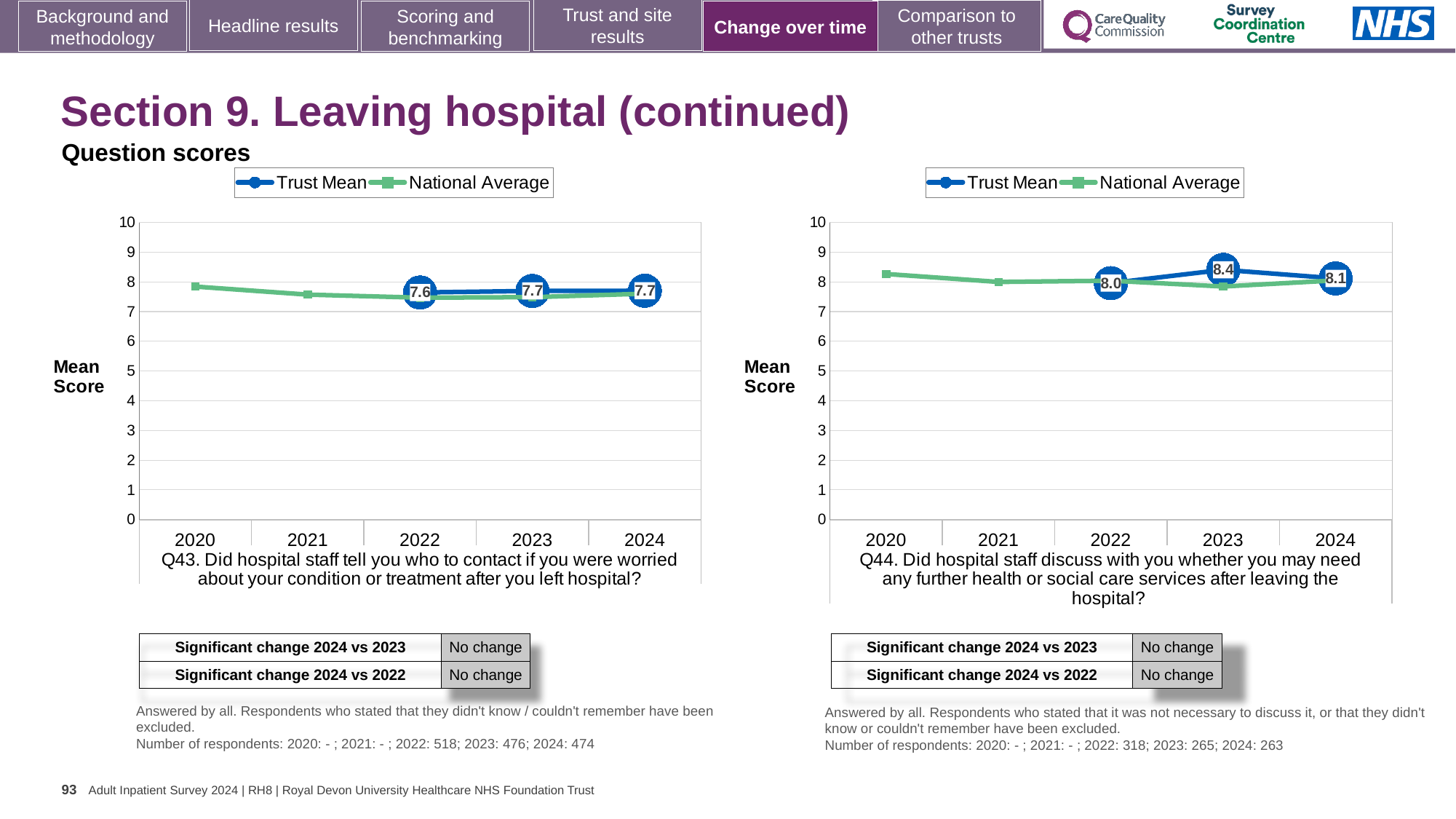
In the Q44 chart on the right, what is the Trust Mean value for 2023? 8.4 How many series does the legend of the Q43 chart on the left list? 2 In the Q44 chart on the right, which is larger, the Trust Mean for 2023 or for 2024? 2023 In the Q43 chart on the left, what is the difference between the Trust Mean values for 2024 and 2022? 0.1 In the Q43 chart on the left, what is the Trust Mean value for 2022? 7.6 In the Q43 chart on the left, which year has the lowest labelled Trust Mean value? 2022 In the Q44 chart on the right, which year has the lowest labelled Trust Mean value? 2022 How many years are shown on the x axis of the Q44 chart on the right? 5 In the Q43 chart on the left, what is the Trust Mean value for 2024? 7.7 In the Q44 chart on the right, which year has the highest Trust Mean value? 2023 In the Q43 chart on the left, is the National Average value for 2020 greater or less than 5? greater In the Q44 chart on the right, what is the difference between the Trust Mean values for 2023 and 2022? 0.4